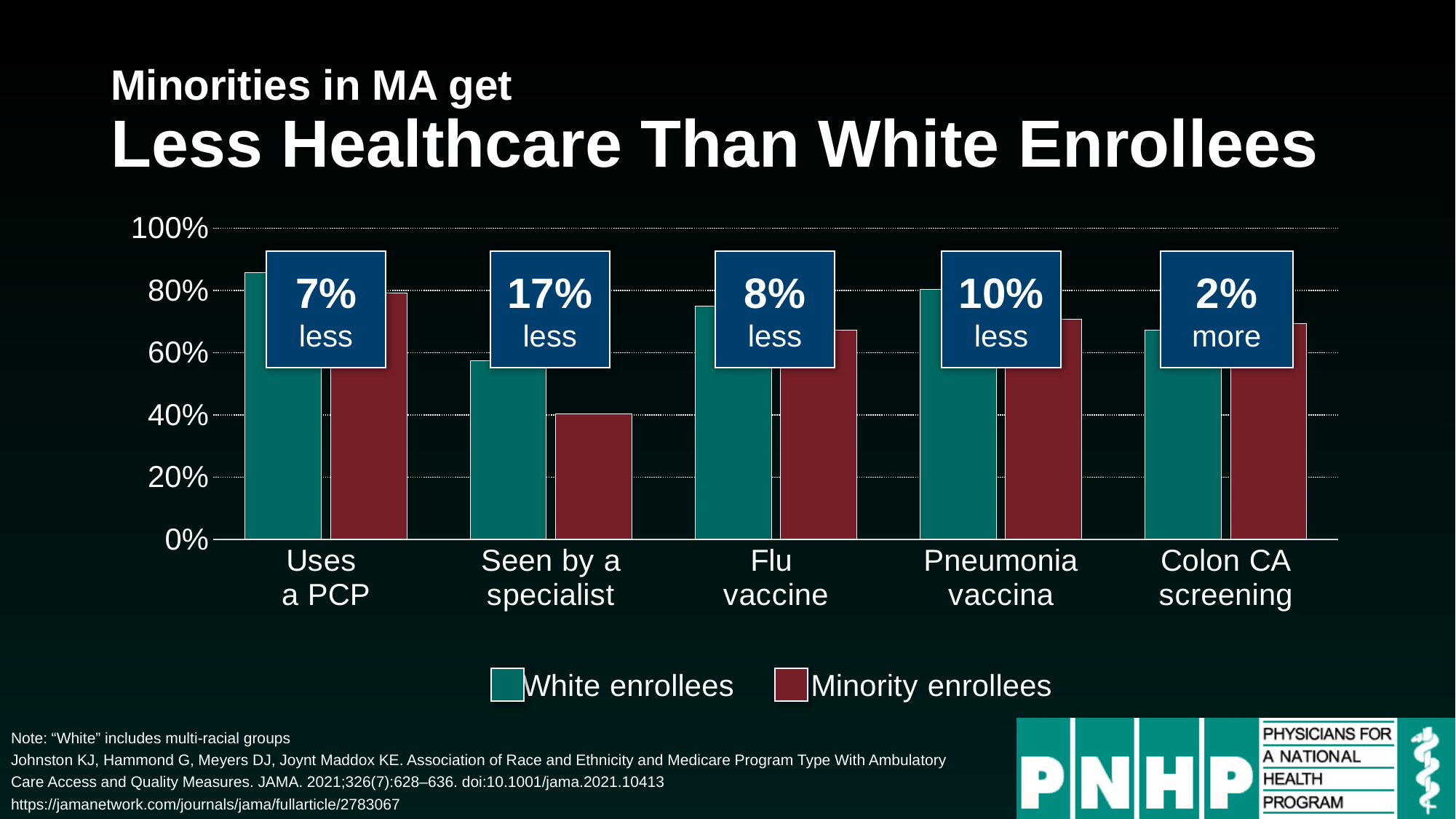
Is the value for Minority enrollees receiving a flu vaccine greater or less than 60%? greater Which category has the lowest value for Minority enrollees? Seen by a specialist How many series does the chart's legend list? 2 Is the value for White enrollees seen by a specialist greater or less than 60%? less Which series is shown in red in the chart? Minority enrollees What does the label above the 'Colon CA screening' bars say? 2% more Which category has the highest value for White enrollees? Uses a PCP What kind of chart is shown on the slide? bar chart Is the value for White enrollees who use a PCP greater or less than 80%? greater For 'Seen by a specialist', which series has the larger value, White enrollees or Minority enrollees? White enrollees What does the label above the 'Seen by a specialist' bars say? 17% less How many categories are shown on the x axis of the chart? 5